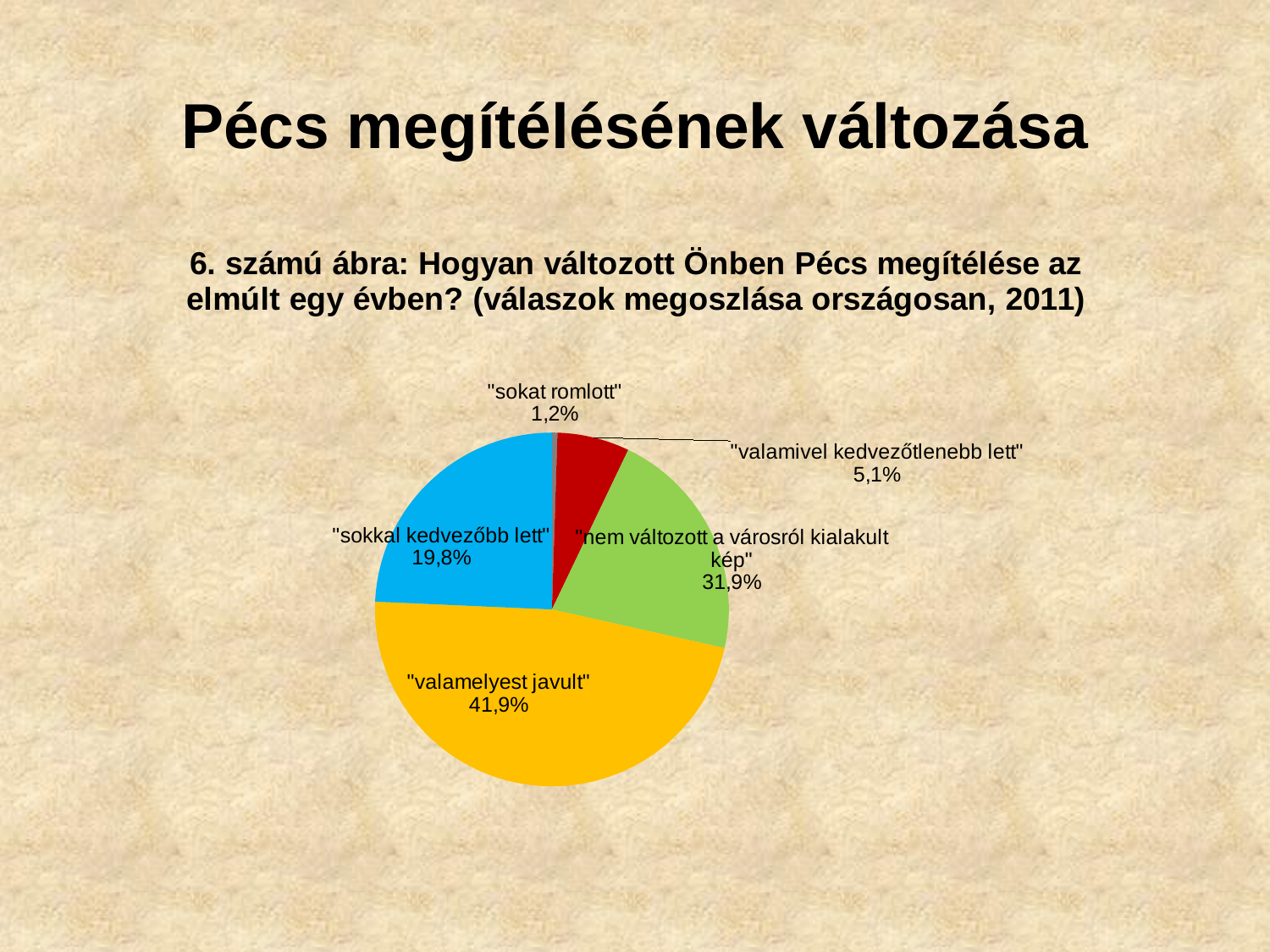
How many slices does the pie chart have? 5 What share of responses is labelled "valamivel kedvezőtlenebb lett"? 5,1% Which response category has the smallest share of the pie? "sokat romlott" What share of responses is labelled "sokat romlott"? 1,2% What colour is the slice for "valamelyest javult"? yellow What is the difference in percentage points between "valamelyest javult" and "nem változott a városról kialakult kép"? 10,0 percentage points Which response category has the largest share of the pie? "valamelyest javult" What kind of chart is shown on the slide? pie chart Which is larger: the share for "sokkal kedvezőbb lett" or the share for "valamivel kedvezőtlenebb lett"? "sokkal kedvezőbb lett" What share of responses is labelled "sokkal kedvezőbb lett"? 19,8% What share of responses is labelled "valamelyest javult"? 41,9% What share of responses is labelled "nem változott a városról kialakult kép"? 31,9%